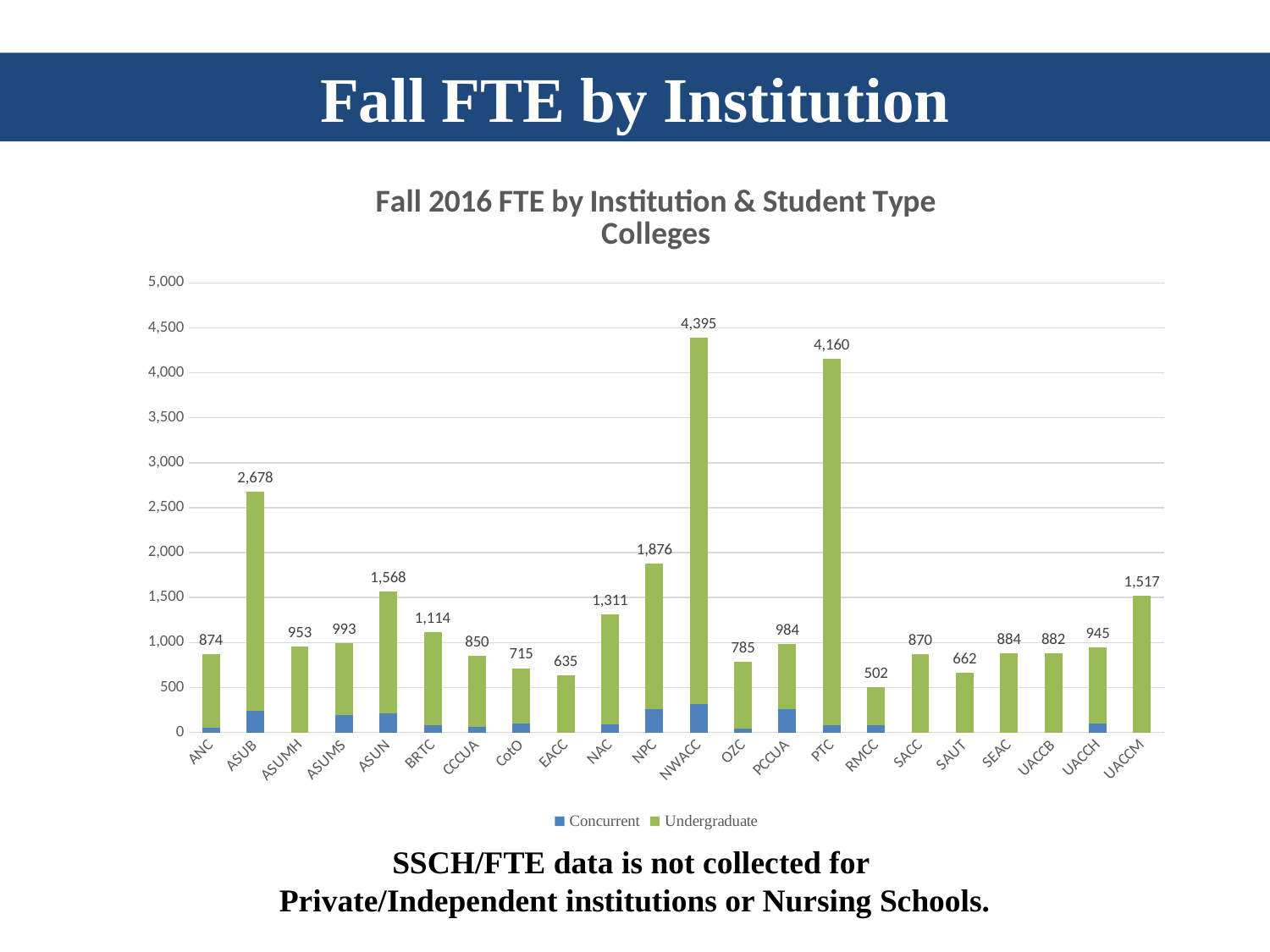
Which institution has the lowest total FTE? RMCC What is the difference between the total FTE for NWACC and PTC? 235 Is the Concurrent value for NWACC greater or less than 500? less Which institution has the highest total FTE? NWACC How many series does the legend list? 2 What is the total Fall 2016 FTE for ASUB? 2,678 Which series is shown in green? Undergraduate How many institutions are shown on the x axis? 22 What type of chart is shown on the slide? Stacked bar chart What is the total Fall 2016 FTE for NWACC? 4,395 Which has a larger total FTE, NPC or UACCM? NPC What is the difference between the total FTE for ASUB and ASUN? 1,110